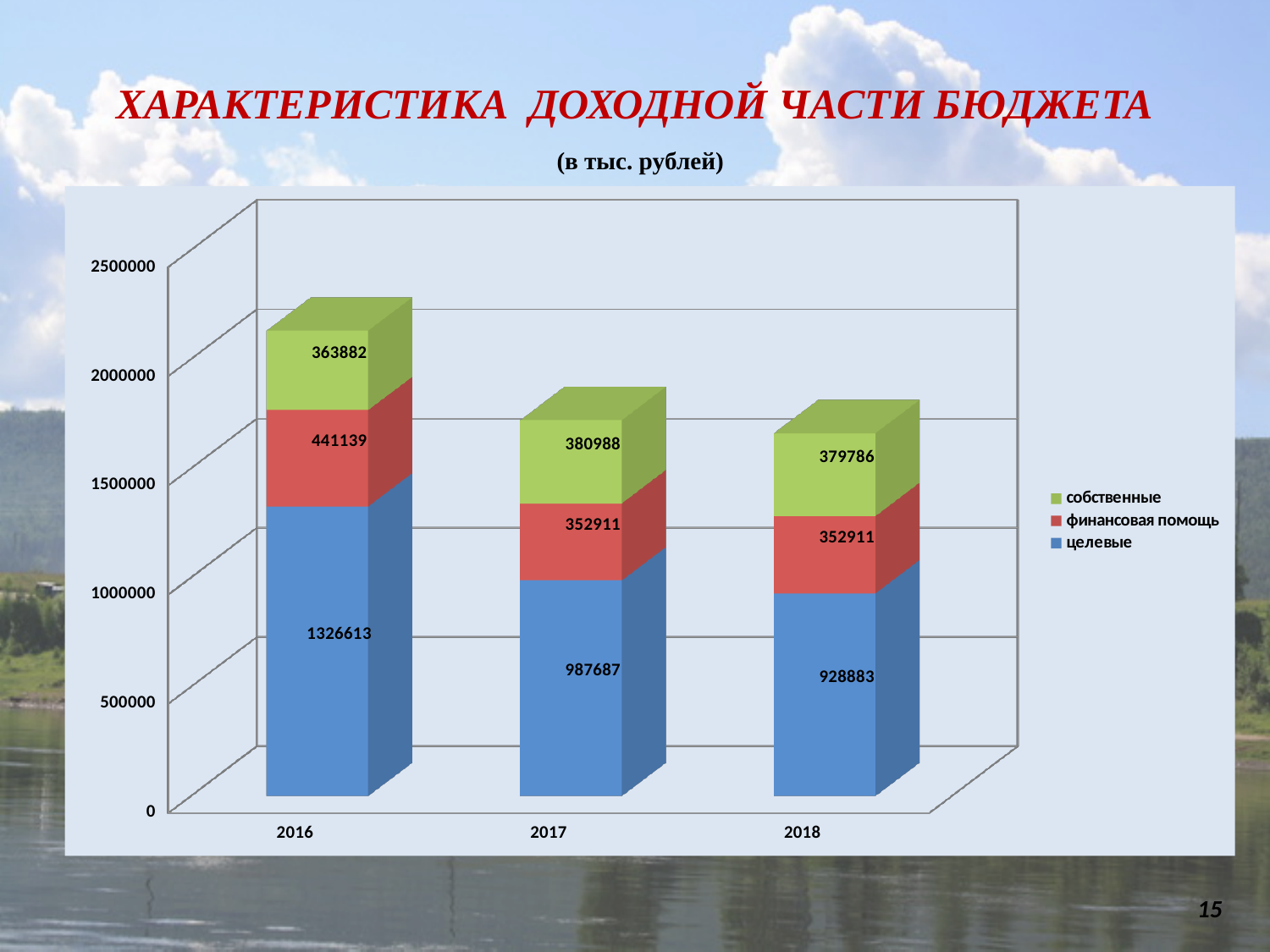
What is the value of собственные for 2018? 379786 What is the total of the stacked bar for 2017? 1721586 In which year is the value of целевые the lowest? 2018 What is the value of целевые for 2016? 1326613 In which year is the value of целевые the highest? 2016 What is the value of финансовая помощь for 2017? 352911 How many series does the legend list? 3 Do the целевые values rise or fall from 2016 to 2018? fall What is the difference between the целевые values for 2016 and 2017? 338926 What kind of chart is shown on the slide? stacked bar chart How many years are shown on the x axis? 3 Which is larger: финансовая помощь in 2016 or in 2018? 2016